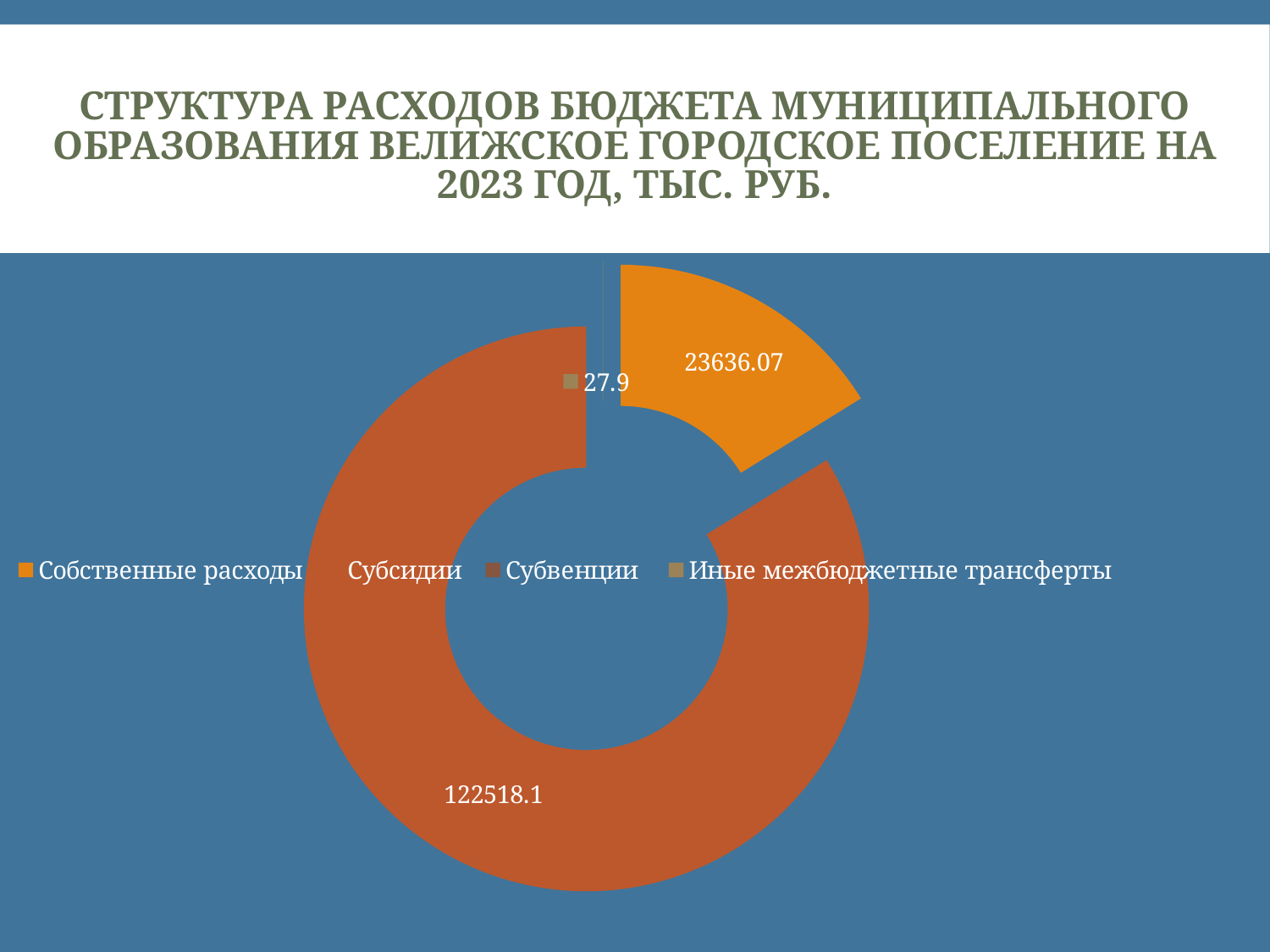
What is the value shown for Собственные расходы? 23636.07 What kind of chart is shown on the slide? Doughnut (pie) chart How many categories does the legend list? 4 What colour is the slice for Собственные расходы? Orange How many data labels are printed on the chart? 3 What is the largest value printed on the chart? 122518.1 What is the smallest value printed on the chart? 27.9 What is the difference between the largest printed value and the value for Собственные расходы? 98882.03 What is the difference between the value for Собственные расходы and the value for Иные межбюджетные трансферты? 23608.17 Which is larger, Собственные расходы or Иные межбюджетные трансферты? Собственные расходы What is the value shown for Иные межбюджетные трансферты? 27.9 For which year does the chart title say the budget expenditure structure is shown? 2023